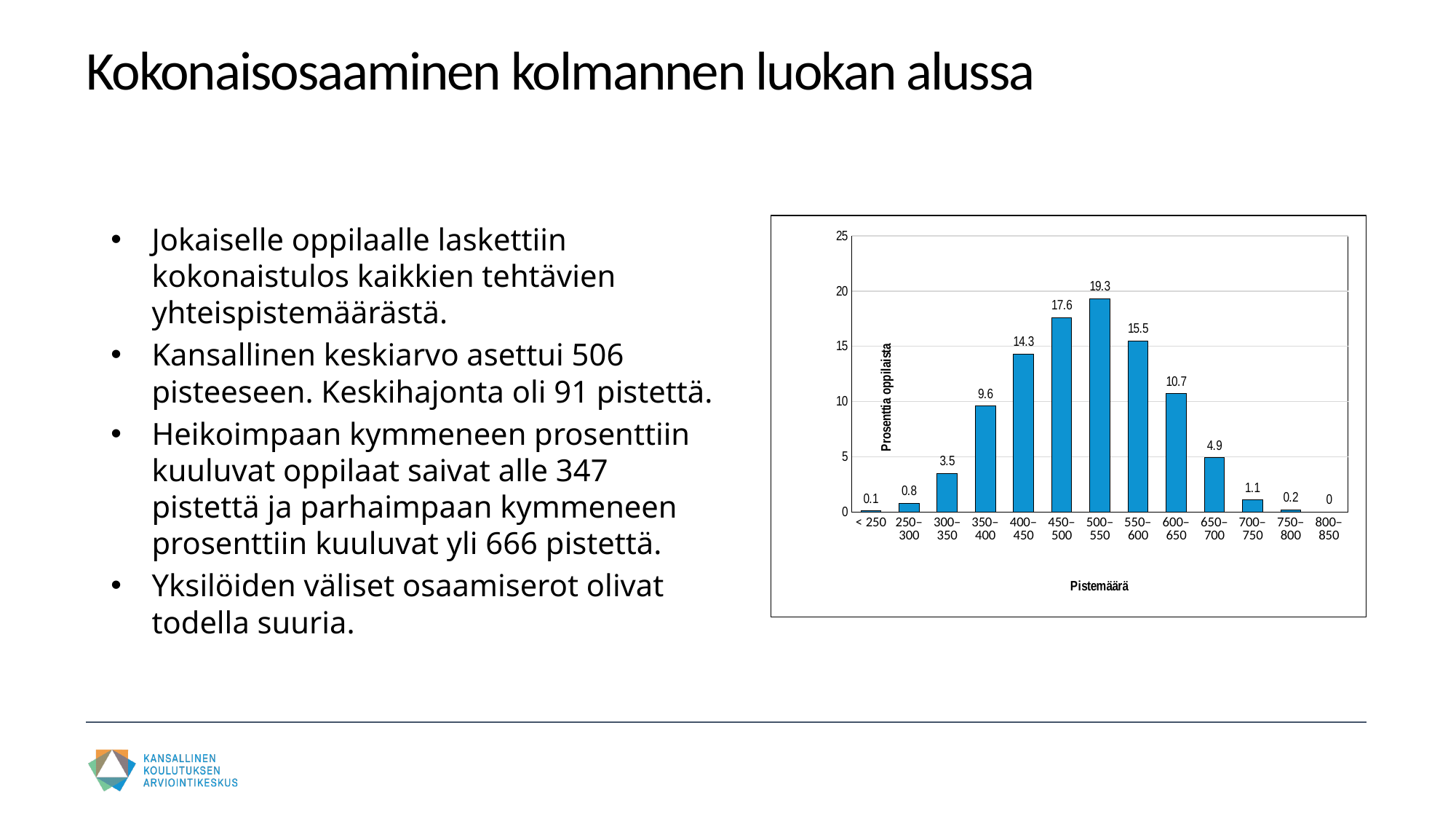
What is the difference between the values for 450–500 and 550–600? 2.1 What is the label of the x axis? Pistemäärä Which score range has the highest percentage of pupils? 500–550 What is the value for the 650–700 score range? 4.9 Do the values rise or fall from 500–550 to 800–850 along the x axis? Fall What kind of chart is shown on the slide? Bar chart What percentage of pupils scored 500–550 points? 19.3 Which score range has the lowest percentage of pupils? 800–850 How many score ranges are shown on the x axis? 13 What is the value for the 350–400 score range? 9.6 Which is larger, the value for 400–450 or the value for 600–650? 400–450 What is the label of the y axis? Prosenttia oppilaista